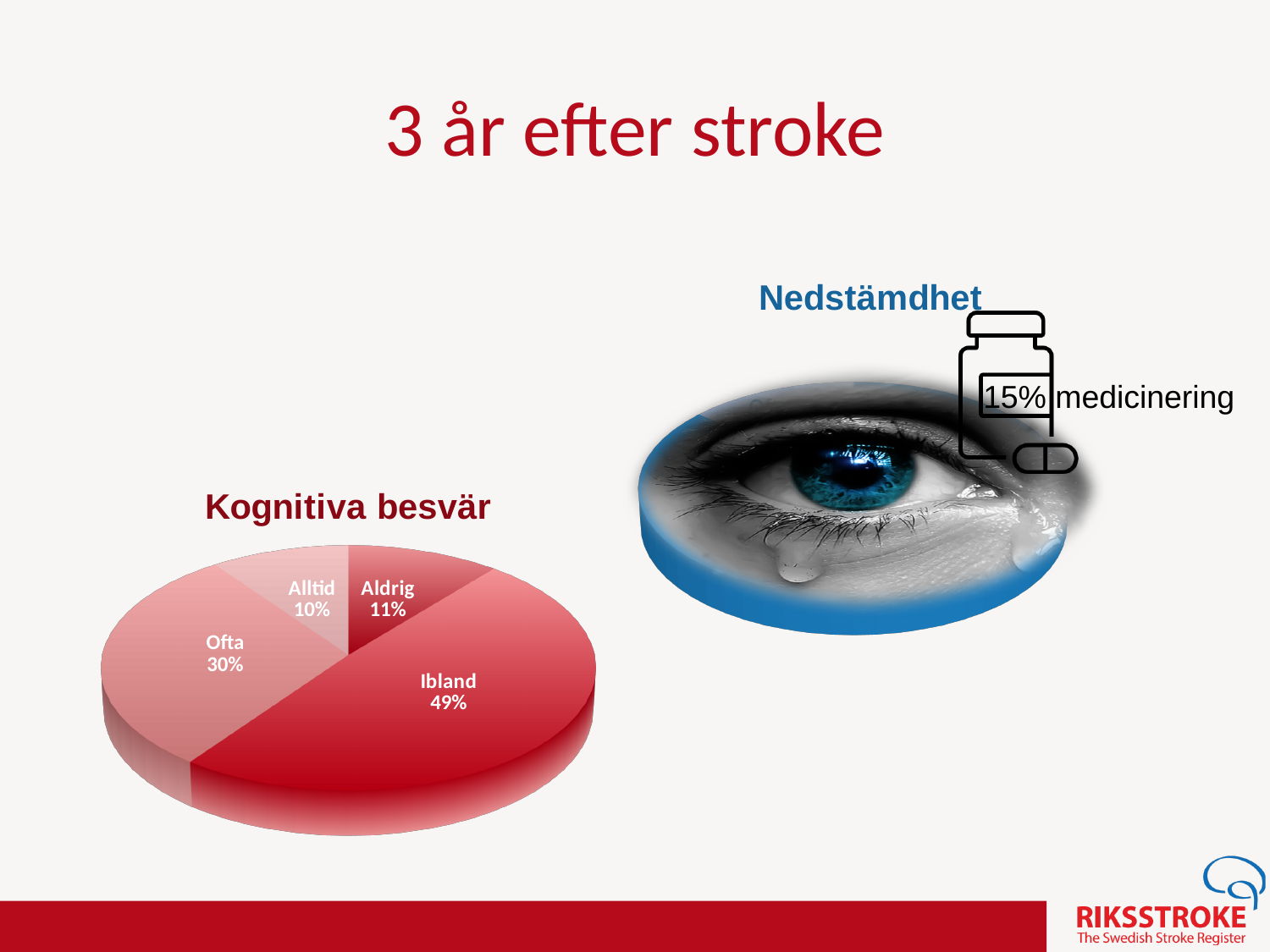
In the Kognitiva besvär chart, what share is labelled Alltid? 10% In the Kognitiva besvär chart, what share is labelled Ofta? 30% In the Kognitiva besvär chart, which is larger, Ofta or Aldrig? Ofta In the Kognitiva besvär chart, what is the combined share of Ofta and Alltid? 40% How many slices does the Kognitiva besvär pie chart have? 4 In the Kognitiva besvär chart, what share is labelled Ibland? 49% In the Kognitiva besvär chart, which category has the largest slice? Ibland What is the title of the pie chart on the left of the slide? Kognitiva besvär In the Kognitiva besvär chart, which category has the smallest slice? Alltid In the Kognitiva besvär chart, what is the difference in percentage points between Ibland and Ofta? 19 In the Kognitiva besvär chart, what share is labelled Aldrig? 11% What kind of chart is the Kognitiva besvär chart? Pie chart